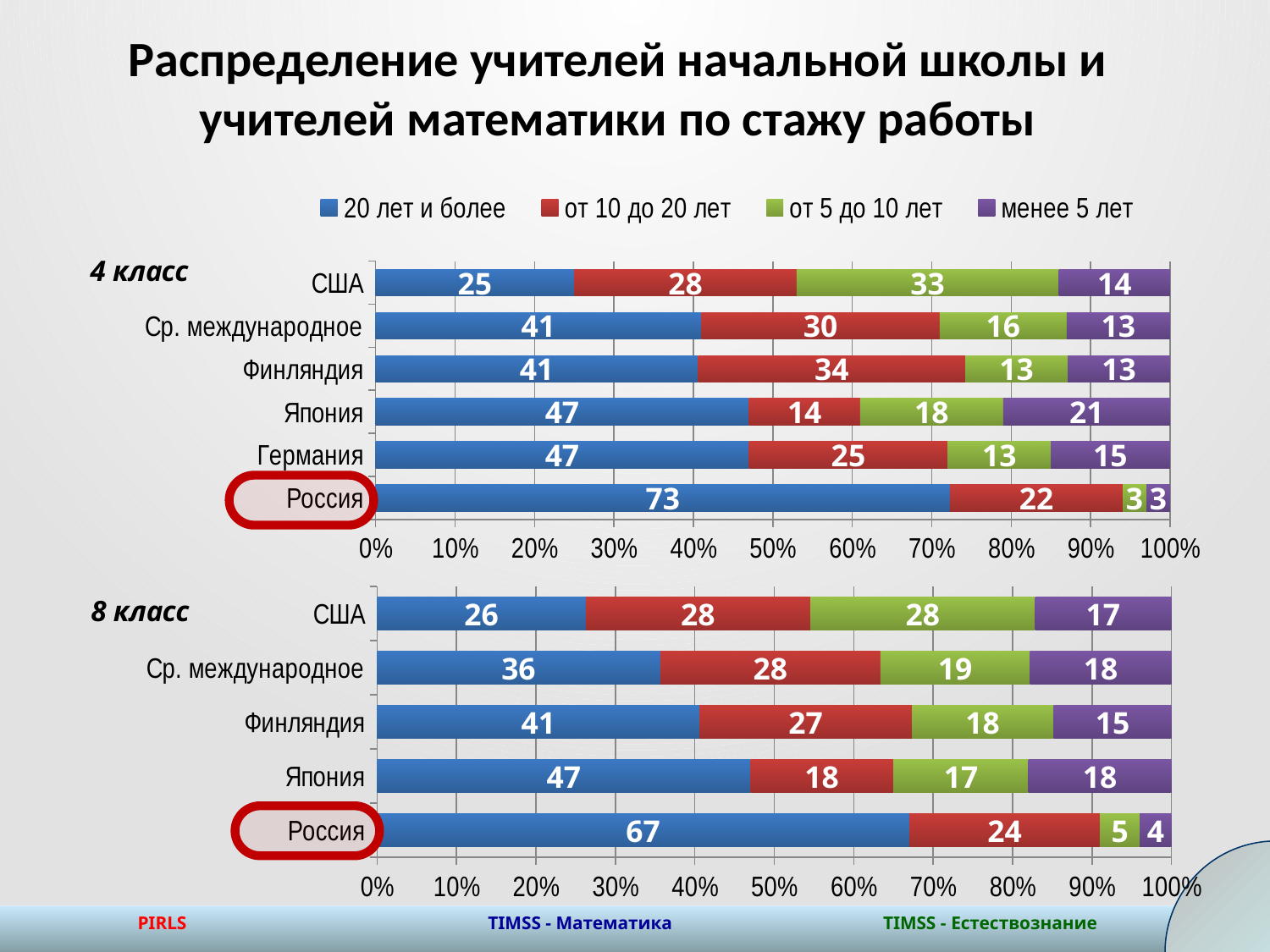
In the top chart (4 класс), which category has the highest value in the '20 лет и более' series? Россия Which category is circled in red on both charts? Россия In the bottom chart (8 класс), what is the total of the stacked bar for США? 99 How many categories are shown in the bottom chart (8 класс)? 5 In the bottom chart (8 класс), which is larger for Финляндия: the 'от 10 до 20 лет' value or the 'от 5 до 10 лет' value? от 10 до 20 лет What kind of chart is used on this slide? Stacked bar chart How many categories are shown in the top chart (4 класс)? 6 In the top chart (4 класс), what is the difference between the '20 лет и более' values for Россия and США? 48 In the bottom chart (8 класс), what is the value for Япония in the 'от 10 до 20 лет' series? 18 How many series does the legend list? 4 In the bottom chart (8 класс), which category has the lowest value in the 'менее 5 лет' series? Россия In the top chart (4 класс), what is the value for Россия in the '20 лет и более' series? 73